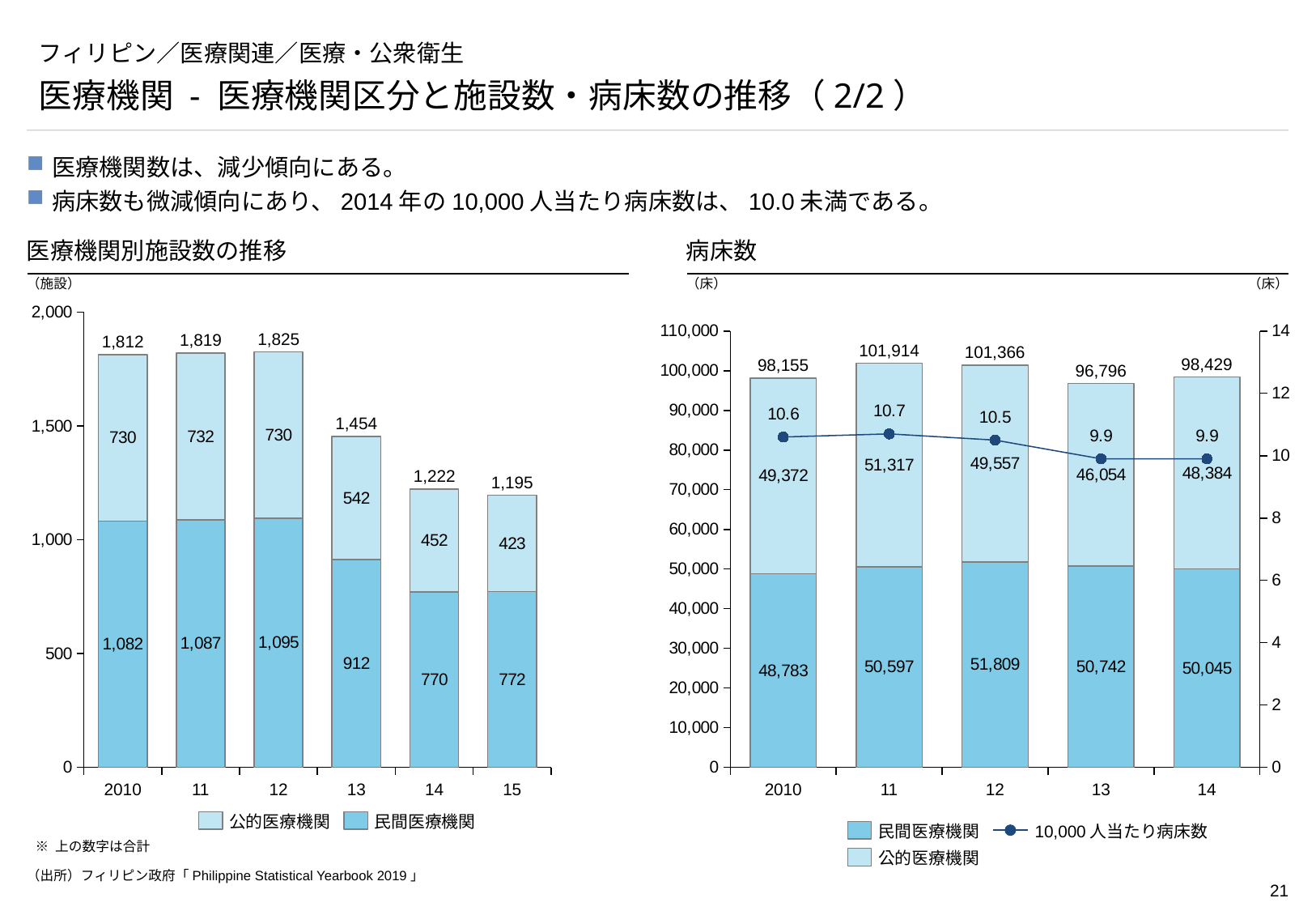
In the left chart (医療機関別施設数の推移), what is the value for 民間医療機関 in 2013? 912 In the right chart (病床数), which year has the highest total number of beds? 11 In the left chart (医療機関別施設数の推移), how many years are shown on the x axis? 6 In the right chart (病床数), how many series does the legend list? 3 In the left chart (医療機関別施設数の推移), what is the difference between the 公的医療機関 values for 2012 and 2013? 188 What kind of chart is the left chart (医療機関別施設数の推移)? stacked bar chart In the left chart (医療機関別施設数の推移), do the total values rise or fall from 2012 to 2015? fall In the left chart (医療機関別施設数の推移), what is the total number of facilities in 2012? 1,825 In the left chart (医療機関別施設数の推移), which year has the lowest total number of facilities? 15 In the right chart (病床数), what is the value for 公的医療機関 in 2011? 51,317 In the right chart (病床数), which is larger in 2012: 民間医療機関 or 公的医療機関? 民間医療機関 In the right chart (病床数), what is the 10,000人当たり病床数 value for 2014? 9.9